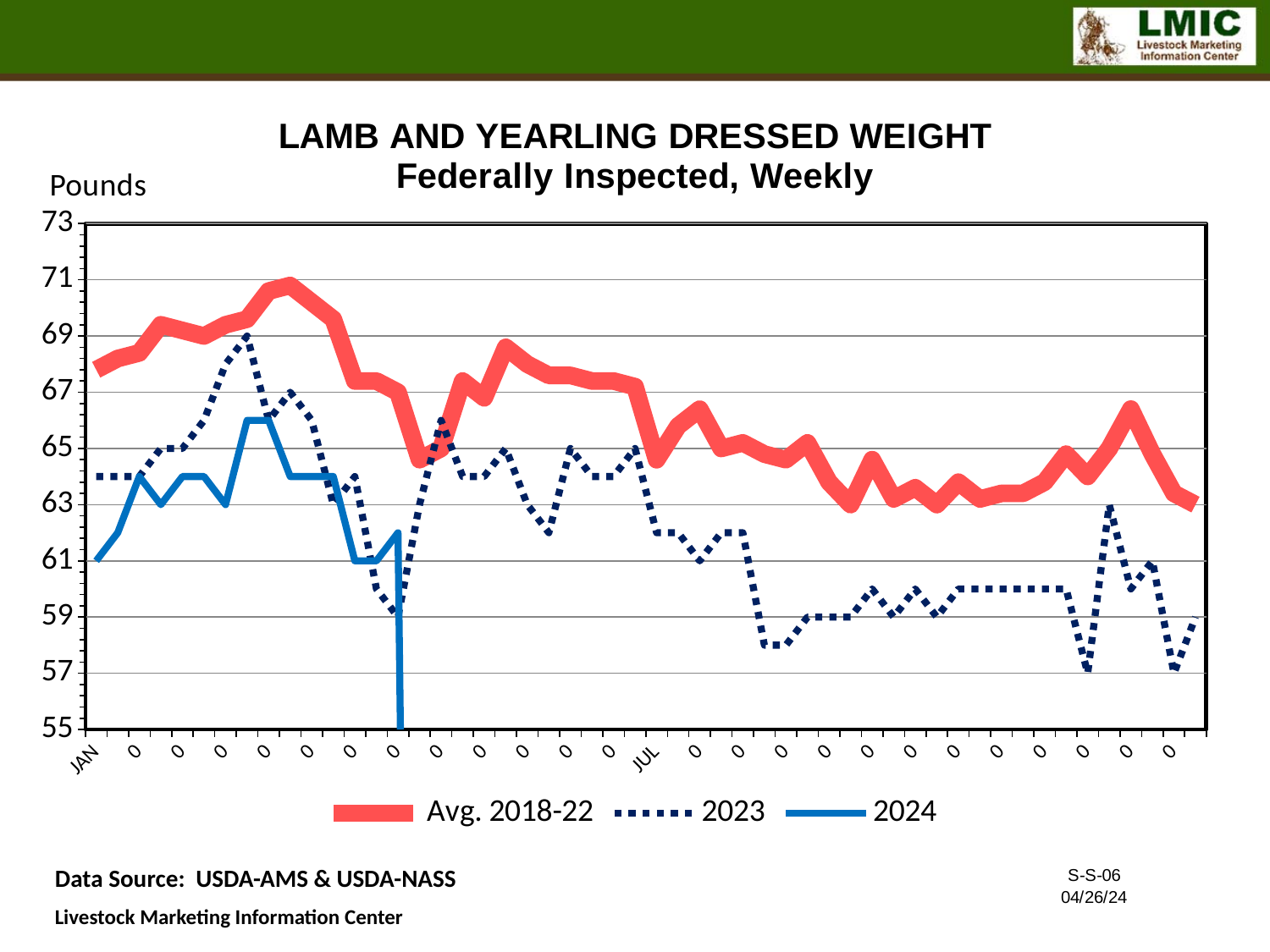
How many series does the legend list? 3 Is the Avg. 2018-22 value at JAN greater or less than 65? greater Is the peak value of the Avg. 2018-22 series greater or less than 69? greater What is the title of the chart? LAMB AND YEARLING DRESSED WEIGHT Federally Inspected, Weekly Is the 2023 value at JUL greater or less than 63? less Which series is drawn as a dotted line? 2023 What kind of chart is shown on the slide? line chart At JAN, which series has the higher value, Avg. 2018-22 or 2024? Avg. 2018-22 Which series reaches the highest value anywhere on the chart? Avg. 2018-22 Does the 2023 series generally rise or fall from JUL to the end of the year? fall